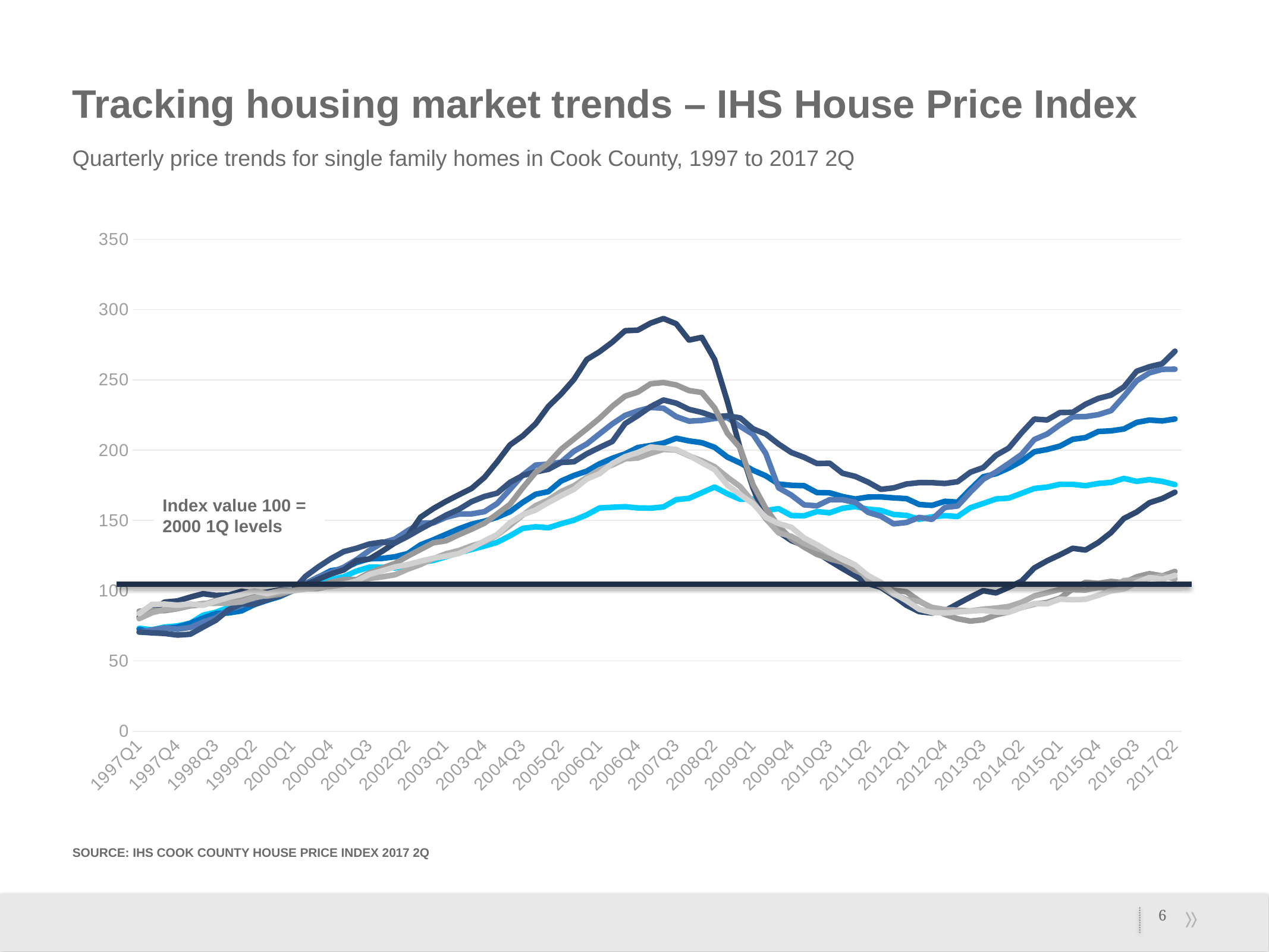
Is the value of the lowest line at 2013Q3 greater or less than 100? less Is the value of the light cyan line at 2017Q2 greater or less than 200? less What kind of chart is shown on the slide? line chart From 2012Q4 to 2017Q2, does the light cyan line rise or fall? rise According to the annotation on the chart, what does an index value of 100 represent? 2000 1Q levels Is the highest value reached by any line around 2007 greater or less than 250? greater What is the first quarter shown on the x axis of the chart? 1997Q1 From 1997Q1 to 2006Q4, do the lines generally rise or fall? rise Between 2007Q3 and 2009Q4, does the line that peaked highest in 2007 rise or fall? fall